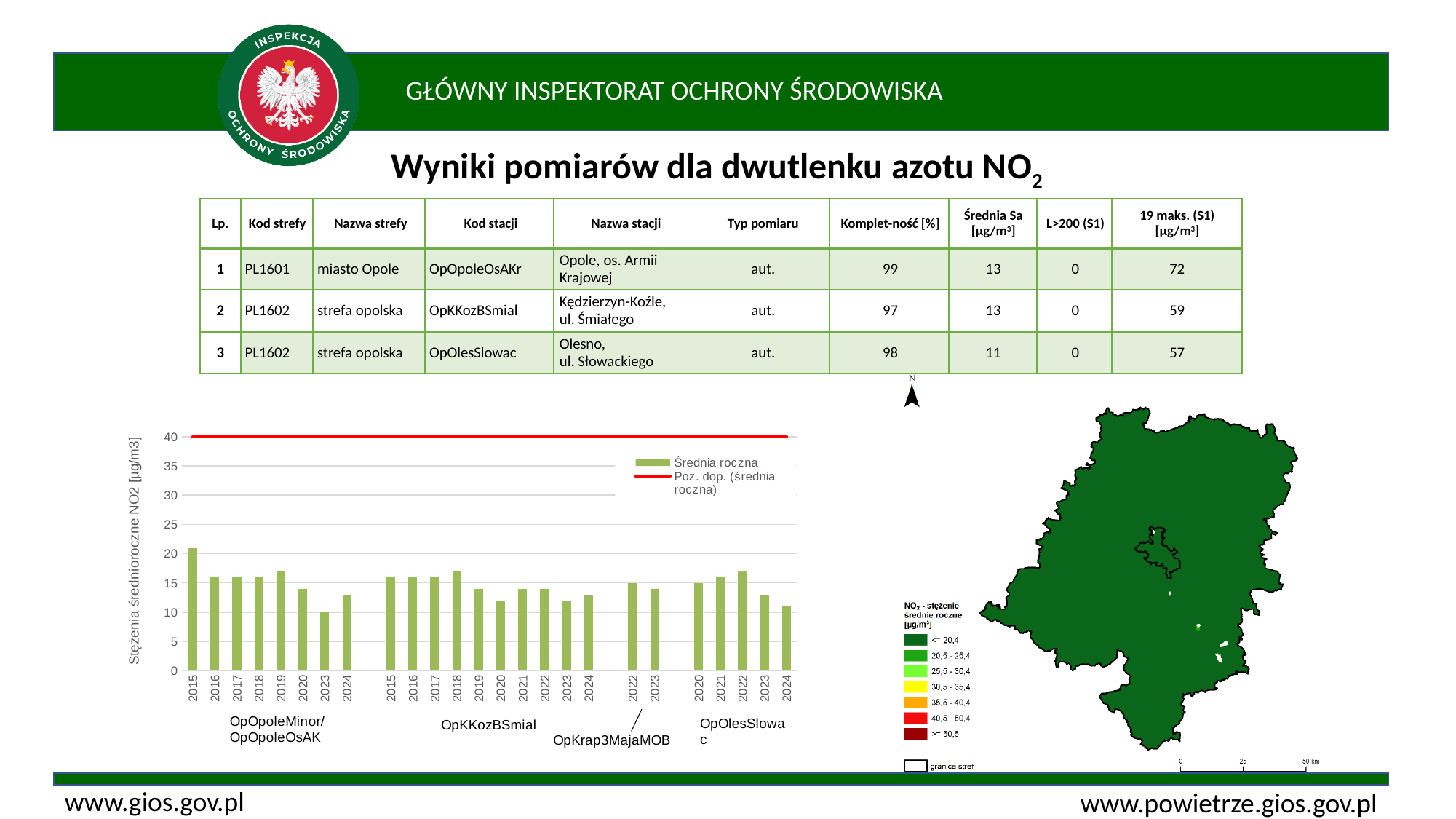
How many series does the legend of the bar chart list? 2 In the bar chart, is the 2024 value for OpOlesSlowac greater or less than 15? less In the bar chart, which is larger for OpOpoleMinor/OpOpoleOsAK: the 2015 value or the 2023 value? 2015 What is the label of the vertical axis of the bar chart? Stężenia średnioroczne NO2 [µg/m3] What kind of chart is shown at the bottom left of the slide? bar chart What is the value of the red 'Poz. dop. (średnia roczna)' line in the bar chart? 40 In the bar chart, is the 2023 value for OpOpoleMinor/OpOpoleOsAK greater or less than 15? less How many yearly bars are shown for OpKKozBSmial in the bar chart? 10 How many yearly bars are shown for OpKrap3MajaMOB in the bar chart? 2 In the bar chart, is the 2015 value for OpOpoleMinor/OpOpoleOsAK greater or less than 15? greater In the bar chart, which station and year has the highest bar? OpOpoleMinor/OpOpoleOsAK, 2015 In the bar chart, do the values for OpOlesSlowac rise or fall from 2022 to 2024? fall